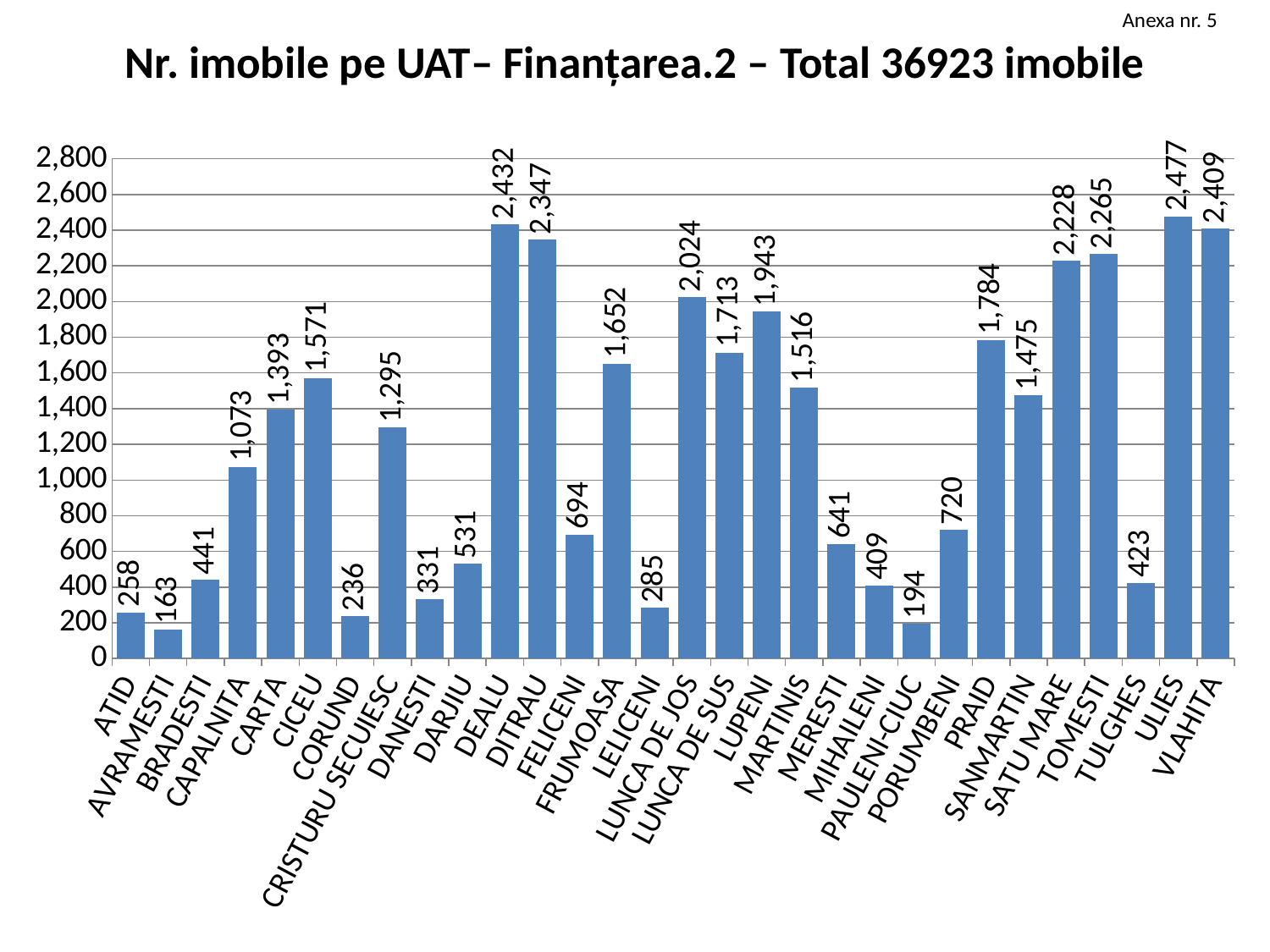
What is the value for CRISTURU SECUIESC? 1,295 What is the difference between the values for PRAID and SANMARTIN? 309 How many UATs are shown on the x axis? 30 Is the value for FELICENI greater or less than 600? greater What total number of imobile is stated in the chart title? 36923 What kind of chart is shown on the slide? bar chart What is the value for DEALU? 2,432 Which UAT has the highest number of imobile? ULIES Which is larger, the value for LUPENI or the value for LUNCA DE SUS? LUPENI Which UAT has the lowest number of imobile? AVRAMESTI What is the value for PAULENI-CIUC? 194 What is the difference between the values for DEALU and DITRAU? 85